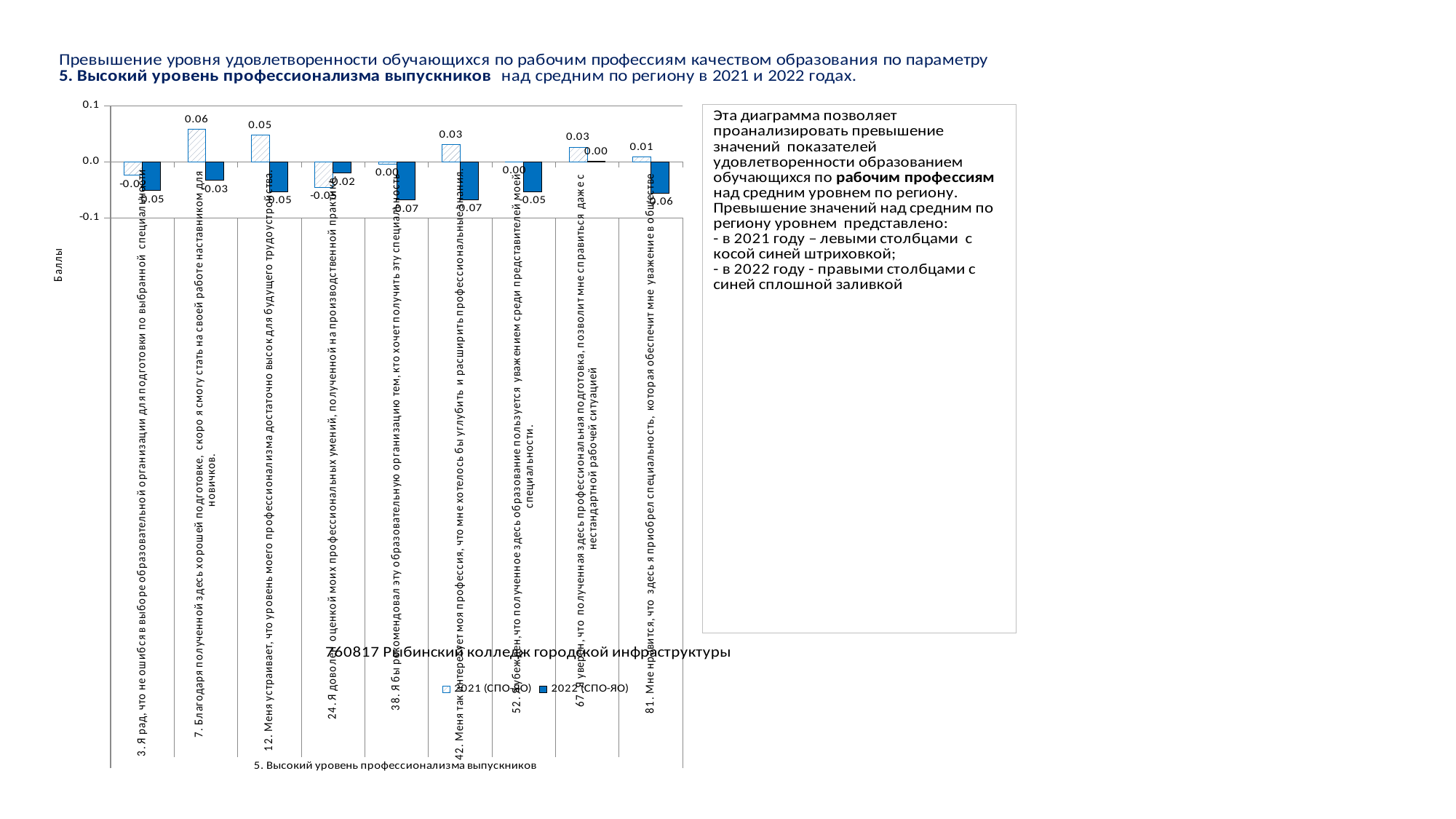
For category 3 (Я рад, что не ошибся в выборе образовательной организации для подготовки по выбранной специальности), which is larger: the 2021 (СПО-ЯО) value or the 2022 (СПО-ЯО) value? 2021 (СПО-ЯО) Which category has the highest 2021 (СПО-ЯО) value? 7. Благодаря полученной здесь хорошей подготовке, скоро я смогу стать на своей работе наставником для новичков. What is the 2022 (СПО-ЯО) value for category 38 (Я бы рекомендовал эту образовательную организацию тем, кто хочет получить эту специальность)? -0.07 Which category has the lowest 2021 (СПО-ЯО) value? 24. Я доволен оценкой моих профессиональных умений, полученной на производственной практике How many categories are shown on the x axis of the chart? 9 Which category has the highest 2022 (СПО-ЯО) value? 67. Я уверен, что полученная здесь профессиональная подготовка, позволит мне справиться даже с нестандартной рабочей ситуацией What is the 2021 (СПО-ЯО) value for category 7 (Благодаря полученной здесь хорошей подготовке, скоро я смогу стать на своей работе наставником для новичков)? 0.06 What is the 2021 (СПО-ЯО) value for category 24 (Я доволен оценкой моих профессиональных умений, полученной на производственной практике)? -0.05 What type of chart is shown on the slide? Bar chart How many series does the chart legend list? 2 What is the difference between the 2021 (СПО-ЯО) and 2022 (СПО-ЯО) values for category 12 (Меня устраивает, что уровень моего профессионализма достаточно высок для будущего трудоустройства)? 0.10 What is the 2022 (СПО-ЯО) value for category 81 (Мне нравится, что здесь я приобрел специальность, которая обеспечит мне уважение в обществе)? -0.06